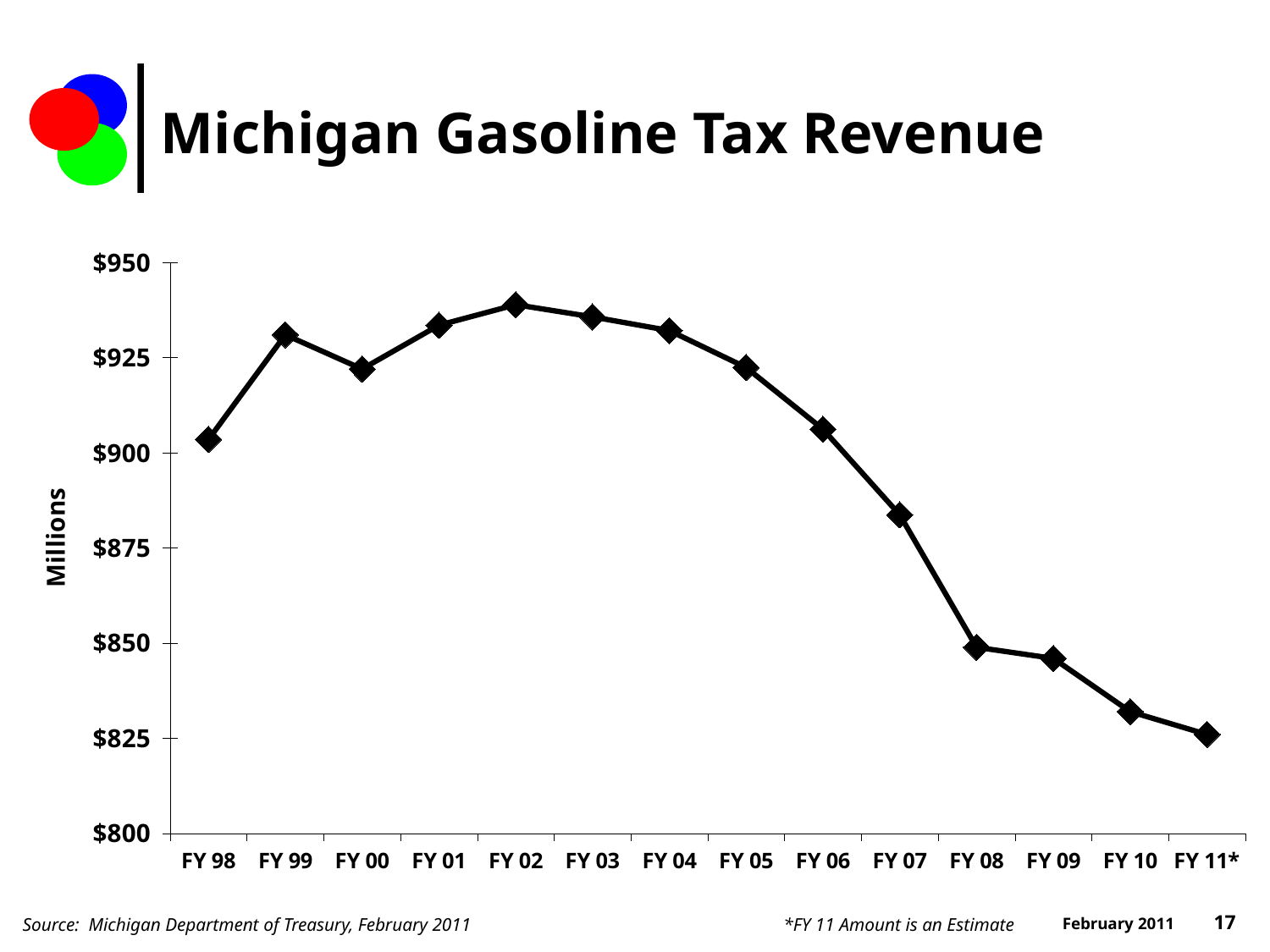
Which fiscal year has the lowest gasoline tax revenue? FY 11* Which is larger, the value for FY 99 or FY 00? FY 99 Is the value for FY 07 greater or less than $900? less Is the value for FY 10 greater or less than $825? greater Is the value for FY 01 greater or less than $925? greater Which is larger, the value for FY 07 or FY 08? FY 07 What is the label on the vertical axis? Millions Which fiscal year has the highest gasoline tax revenue? FY 02 How many fiscal years are plotted on the chart? 14 What kind of chart is shown on the slide? line chart Do the values rise or fall from FY 02 to FY 11*? fall